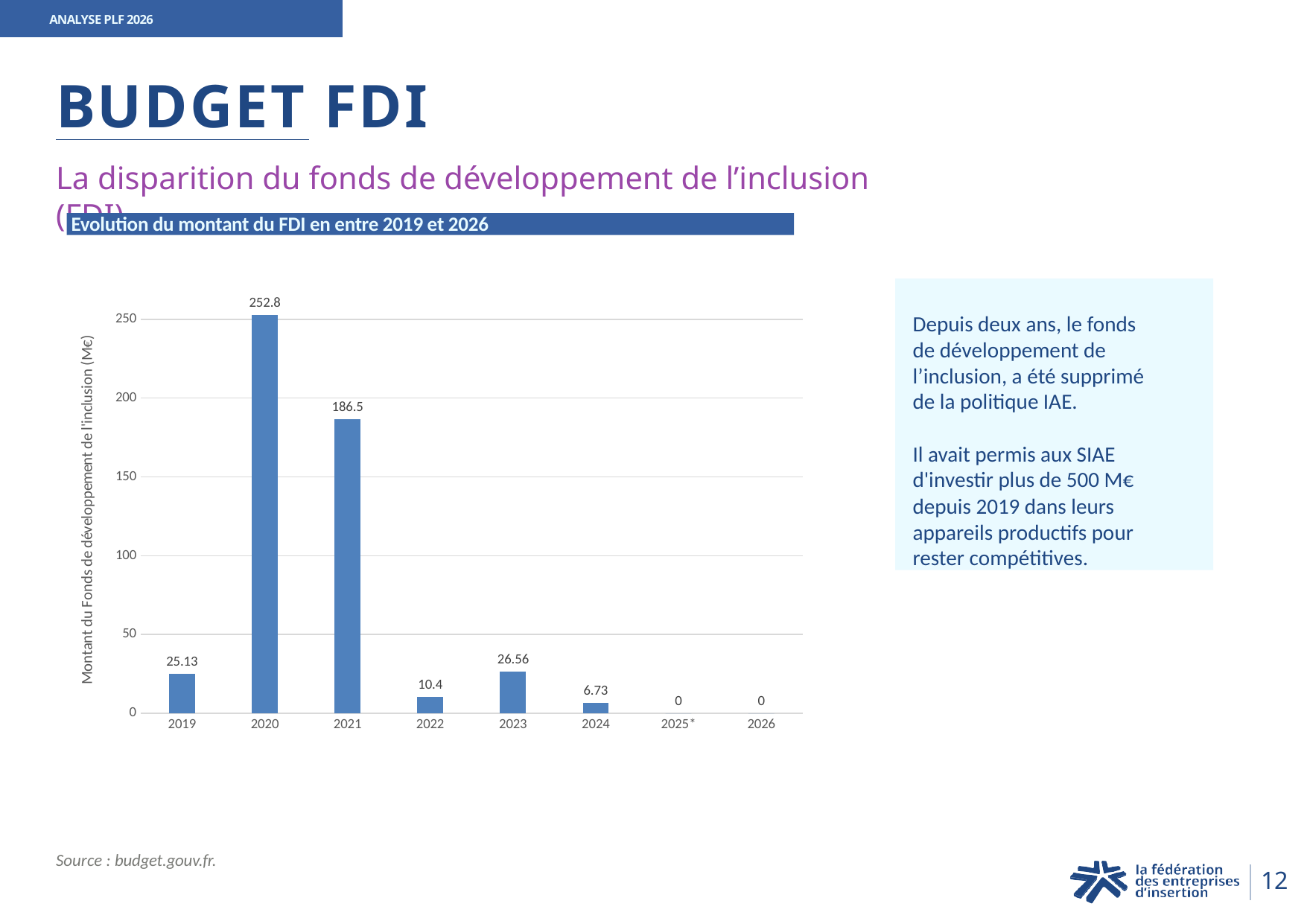
Do the values rise or fall from 2021 to 2022? fall Which is larger, the value for 2019 or the value for 2023? 2023 What kind of chart is shown? bar chart What is the value for 2020? 252.8 What is the difference between the values for 2020 and 2021? 66.3 What is the title of the chart? Evolution du montant du FDI en entre 2019 et 2026 What is the value for 2019? 25.13 Which year has the highest value? 2020 Is the value for 2021 greater or less than 150? greater What is the value for 2024? 6.73 How many years are shown on the x axis? 8 What is the value for 2021? 186.5